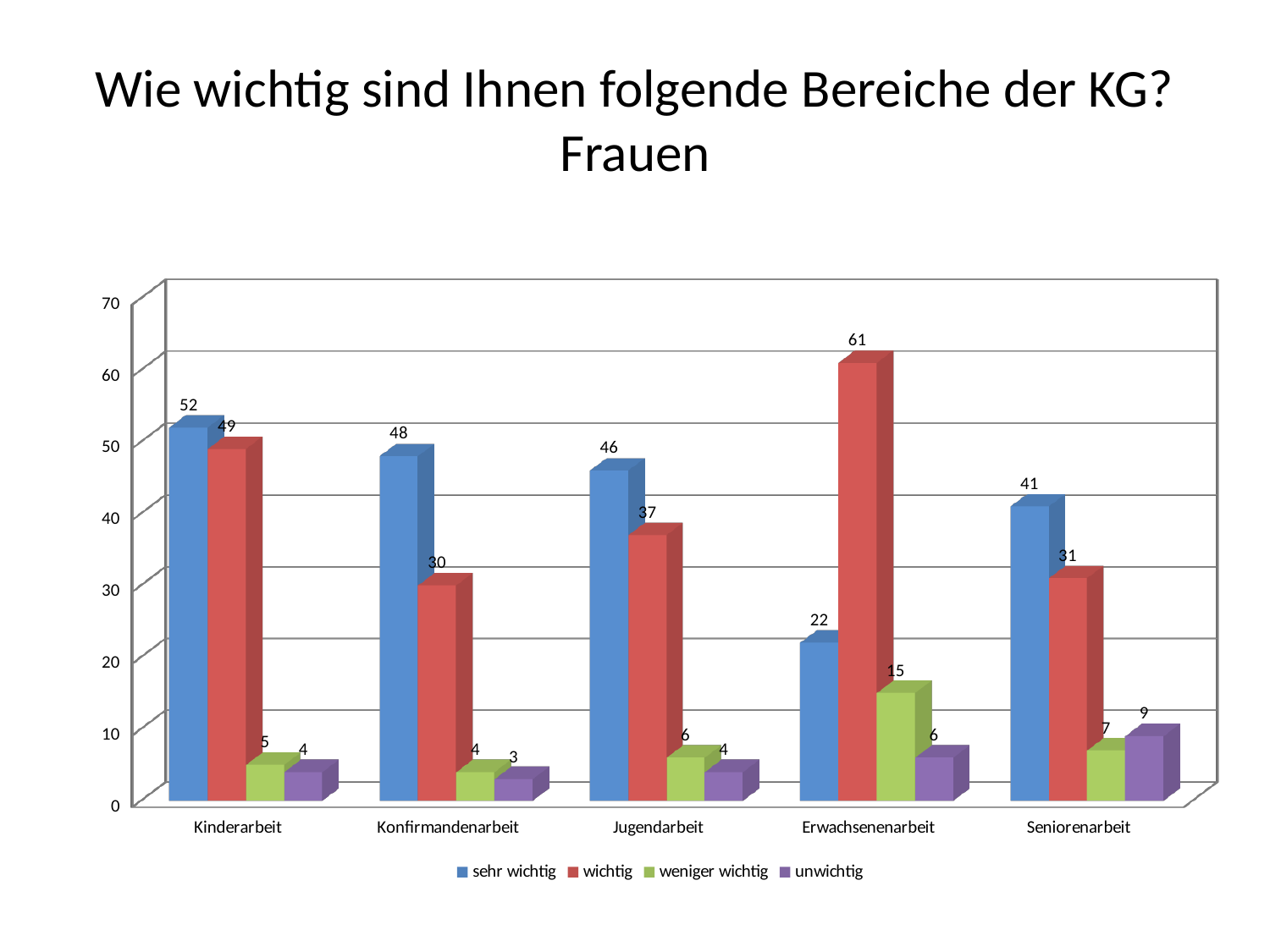
Which category has the highest value for "unwichtig"? Seniorenarbeit What is the difference between the "sehr wichtig" and "wichtig" values for Konfirmandenarbeit? 18 Which is larger for Erwachsenenarbeit: the "sehr wichtig" value or the "wichtig" value? wichtig What is the value for "wichtig" in the Erwachsenenarbeit category? 61 What kind of chart is shown on the slide? bar chart How many series does the legend list? 4 What is the value for "sehr wichtig" in the Kinderarbeit category? 52 Which category has the highest value for "sehr wichtig"? Kinderarbeit What is the value for "weniger wichtig" in the Seniorenarbeit category? 7 How many categories are shown on the x axis? 5 What is the title of the chart on the slide? Wie wichtig sind Ihnen folgende Bereiche der KG? Frauen Which category has the lowest value for "wichtig"? Konfirmandenarbeit